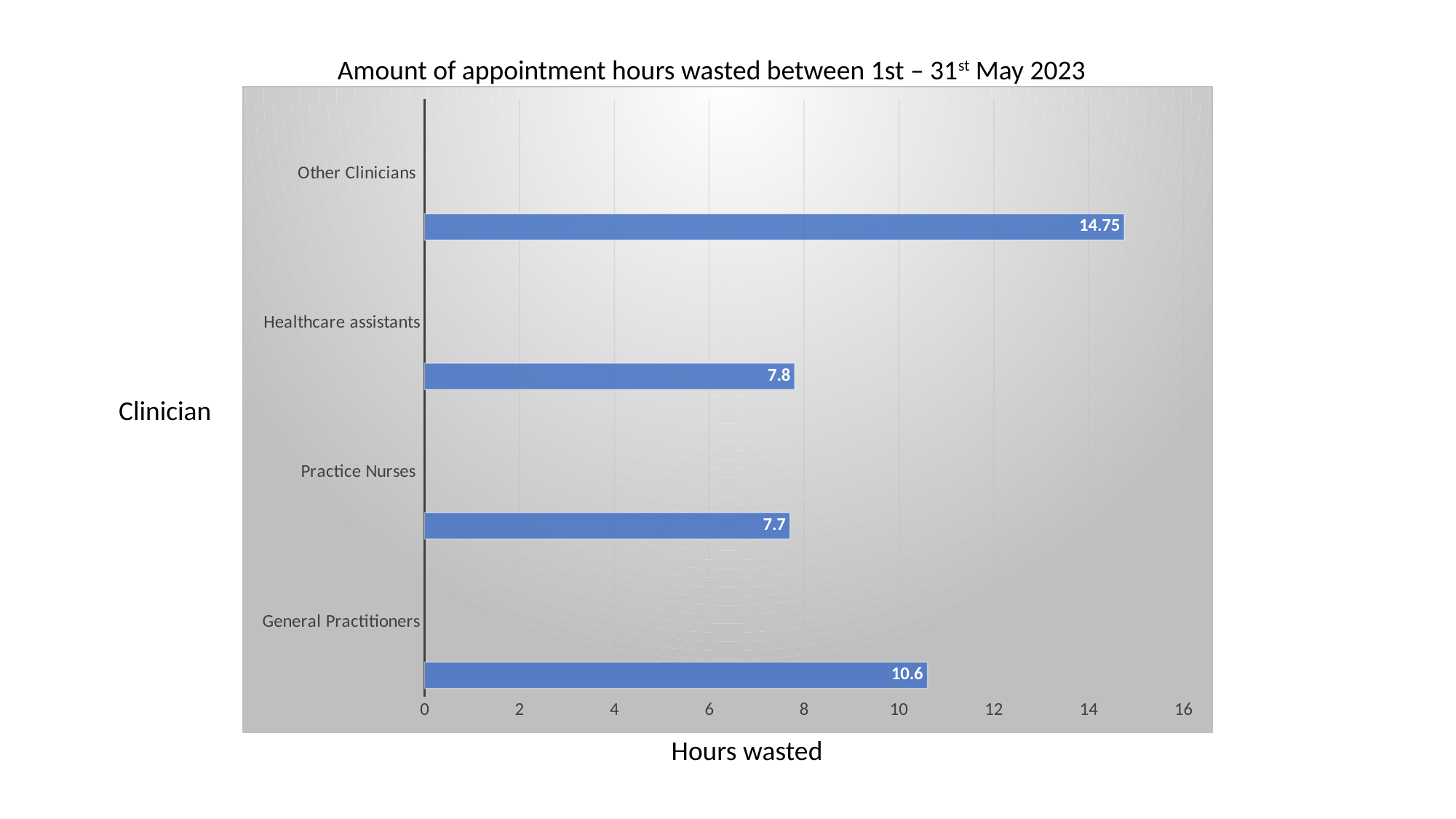
Is the value for Other Clinicians greater or less than 12? greater What is the difference in hours wasted between Other Clinicians and General Practitioners? 4.15 Which clinician group has the highest number of hours wasted? Other Clinicians What is the value for Healthcare assistants? 7.8 What kind of chart is shown on the slide? Bar chart What is the difference in hours wasted between General Practitioners and Healthcare assistants? 2.8 Which clinician group has the lowest number of hours wasted? Practice Nurses What is the value for Practice Nurses? 7.7 Which has more hours wasted, General Practitioners or Healthcare assistants? General Practitioners How many hours were wasted by General Practitioners? 10.6 How many clinician categories are shown on the chart? 4 What is the value for Other Clinicians? 14.75